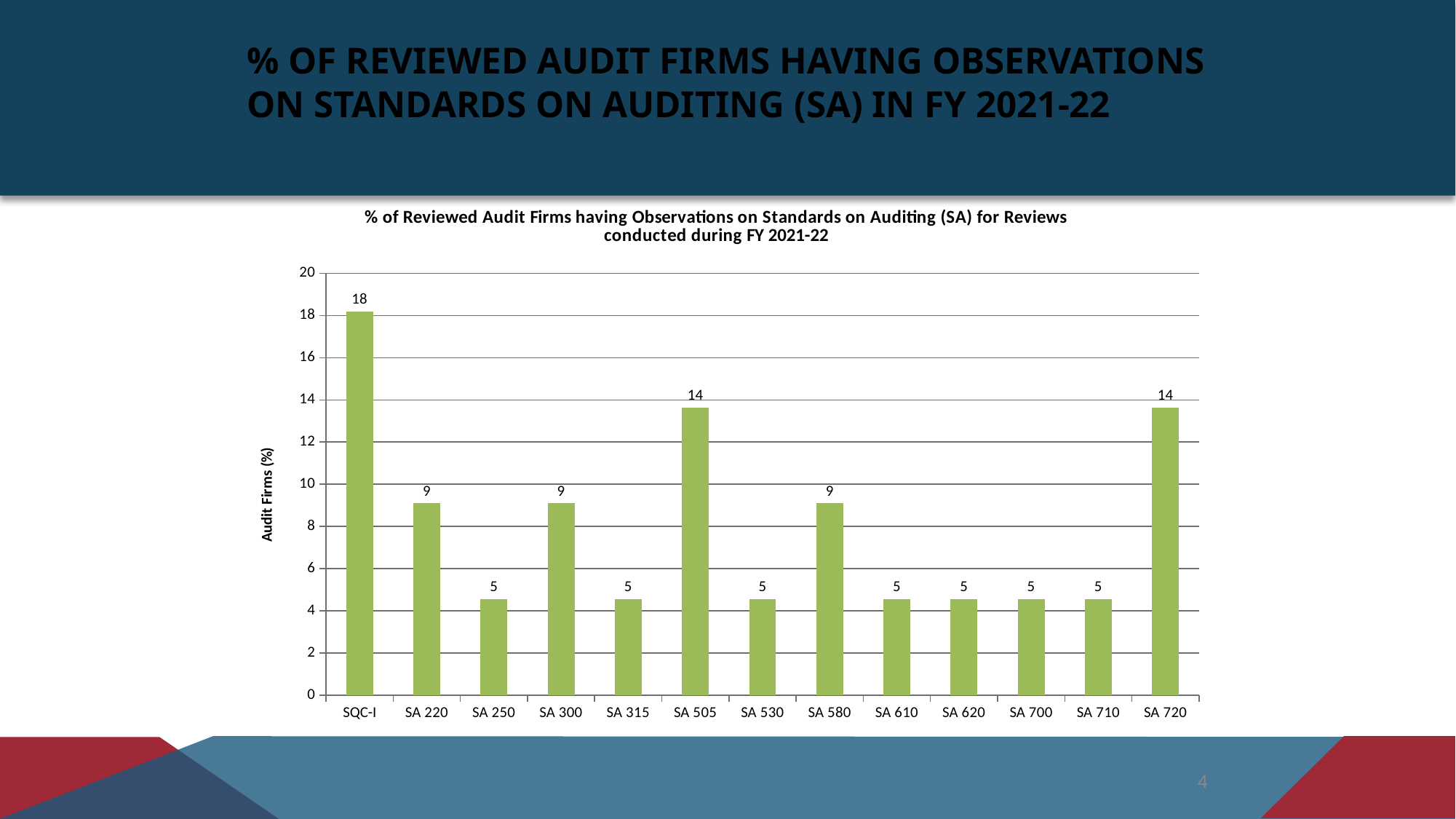
Is the value for SA 720 greater or less than 10? greater What type of chart is shown on the slide? bar chart What is the value for SA 580? 9 What is the value for SA 700? 5 How many categories are shown on the x axis? 13 What is the value for SA 505? 14 Which is larger, the value for SA 505 or the value for SA 220? SA 505 What is the value for SQC-I? 18 What is the difference between the values for SQC-I and SA 720? 4 What is the difference between the values for SA 300 and SA 315? 4 What is the title of the vertical axis? Audit Firms (%) Which category has the highest value? SQC-I